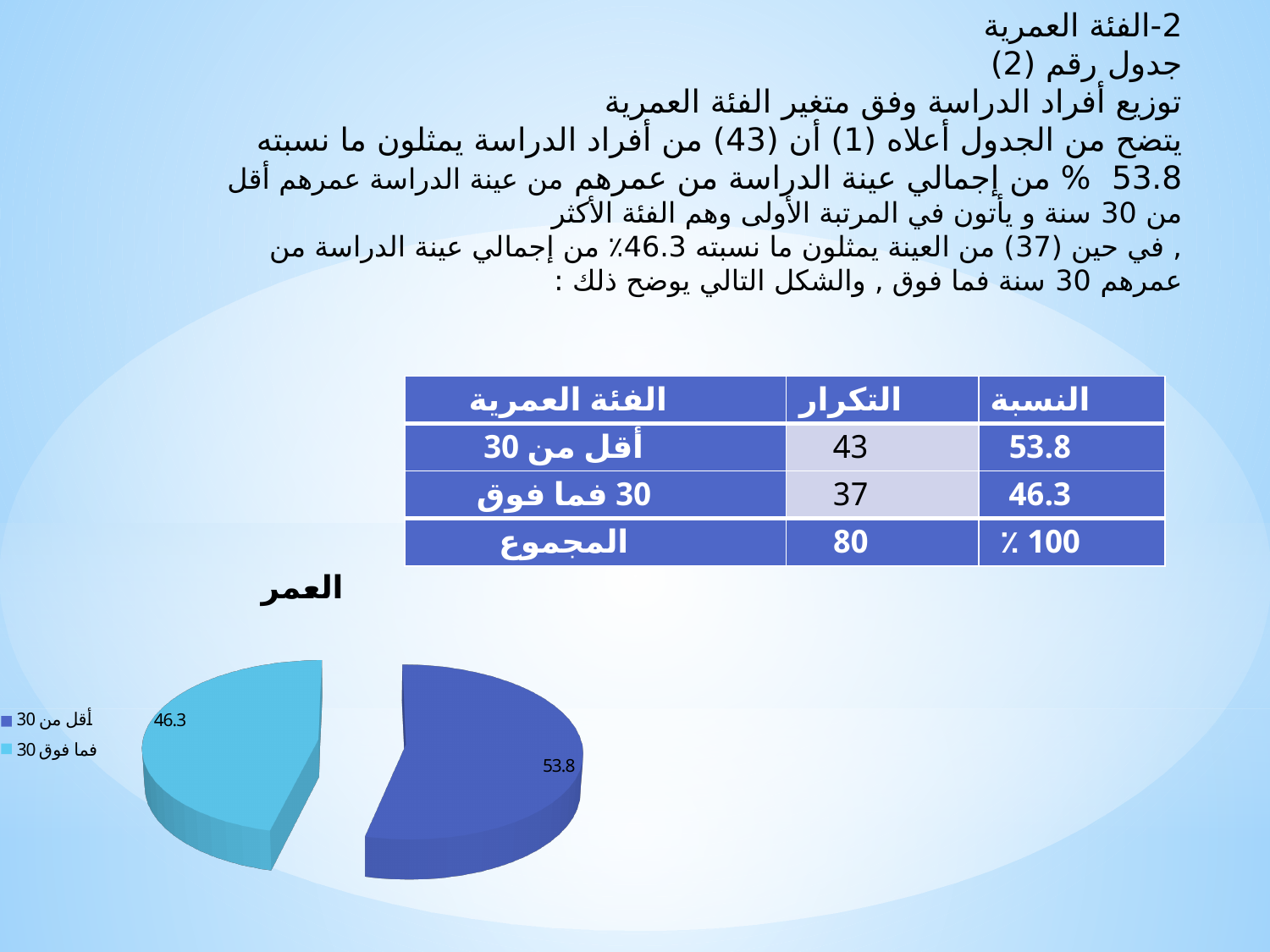
What is the difference between the values of the two slices in the pie chart? 7.5 What kind of chart is shown on the slide? Pie chart What colour is the slice for 30 فما فوق in the pie chart? Light blue Which is larger in the pie chart: أقل من 30 or 30 فما فوق? أقل من 30 What value is shown for the slice labelled أقل من 30 in the pie chart? 53.8 How many entries does the legend of the pie chart list? 2 How many slices does the pie chart have? 2 Which slice of the pie chart is the largest? أقل من 30 Which slice of the pie chart is the smallest? 30 فما فوق What is the title of the pie chart? العمر What value is shown for the slice labelled 30 فما فوق in the pie chart? 46.3